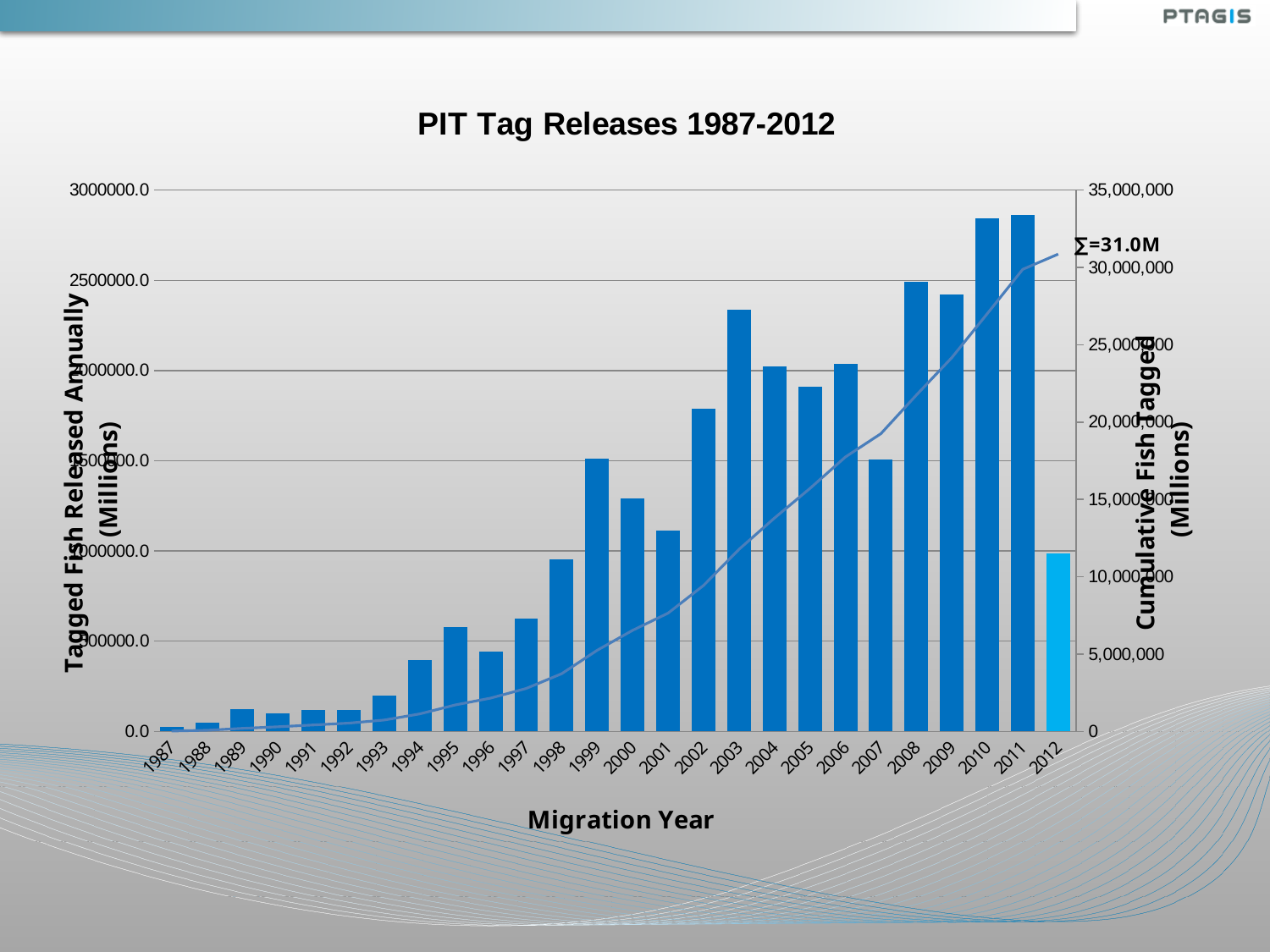
How many migration years are shown on the x axis? 26 Which migration year has the lowest number of tagged fish released annually? 1987 Is the value for tagged fish released annually in 2003 greater or less than 2000000.0? greater Which year has more tagged fish released annually, 1999 or 2000? 1999 What cumulative total is annotated at the end of the line? ∑=31.0M What is the title of the chart? PIT Tag Releases 1987-2012 Is the value for tagged fish released annually in 2007 greater or less than 2000000.0? less Is the value for tagged fish released annually in 2002 greater or less than 1500000.0? greater What kind of chart is shown on the slide? Bar chart with a line Does the cumulative fish tagged line rise or fall from 1987 to 2012? Rises Which year has more tagged fish released annually, 2003 or 2004? 2003